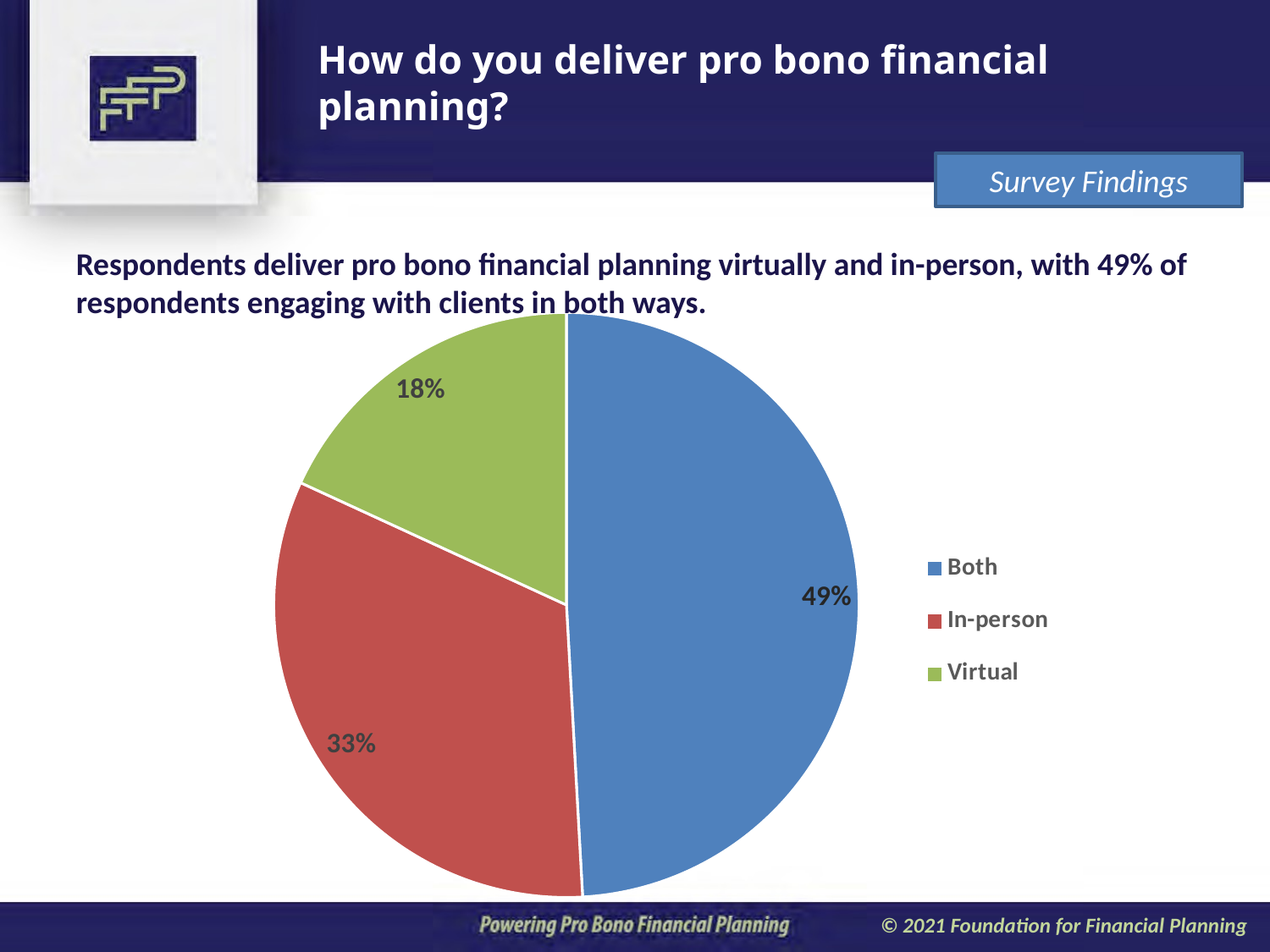
Which delivery method has the largest share of the pie? Both What percentage of respondents deliver pro bono financial planning virtually? 18% What percentage of respondents deliver pro bono financial planning both virtually and in-person? 49% How many categories does the pie chart show? 3 What are the three legend entries of the pie chart? Both, In-person, Virtual Which delivery method has the smallest share of the pie? Virtual What is the difference in percentage points between the Both and In-person slices? 16 What colour is the slice representing In-person delivery? Red What percentage of respondents deliver pro bono financial planning in-person? 33% What is the difference in percentage points between the In-person and Virtual slices? 15 Which is larger, the In-person slice or the Virtual slice? In-person What kind of chart is shown on the slide? Pie chart